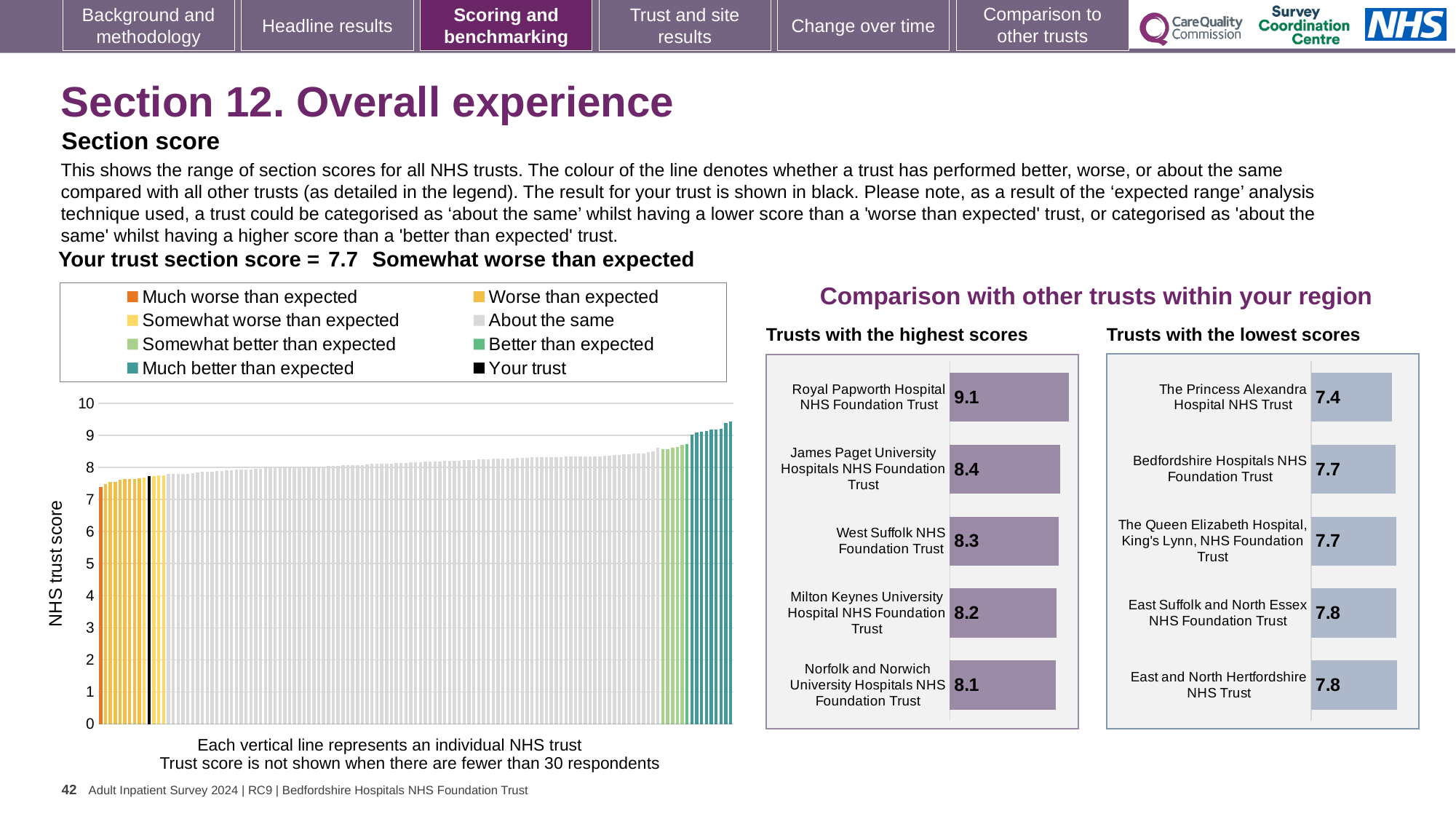
In the 'Trusts with the highest scores' chart, what is the score for Royal Papworth Hospital NHS Foundation Trust? 9.1 In the 'Trusts with the lowest scores' chart, what is the difference between the scores of East Suffolk and North Essex NHS Foundation Trust and The Princess Alexandra Hospital NHS Trust? 0.4 In the 'Trusts with the highest scores' chart, which has the higher score: James Paget University Hospitals NHS Foundation Trust or West Suffolk NHS Foundation Trust? James Paget University Hospitals NHS Foundation Trust What kind of chart is the 'Trusts with the lowest scores' chart? Bar chart How many trusts are shown in the 'Trusts with the highest scores' chart? 5 How many entries does the legend of the main chart on the left list? 8 In the 'Trusts with the lowest scores' chart, which trust has the lowest score? The Princess Alexandra Hospital NHS Trust In the 'Trusts with the highest scores' chart, what is the difference between the scores of Royal Papworth Hospital NHS Foundation Trust and Norfolk and Norwich University Hospitals NHS Foundation Trust? 1.0 What is the y-axis label of the main chart on the left? NHS trust score In the main chart on the left, what is the section score for your trust? 7.7 In the 'Trusts with the lowest scores' chart, what is the score for The Princess Alexandra Hospital NHS Trust? 7.4 In the 'Trusts with the highest scores' chart, which trust has the highest score? Royal Papworth Hospital NHS Foundation Trust